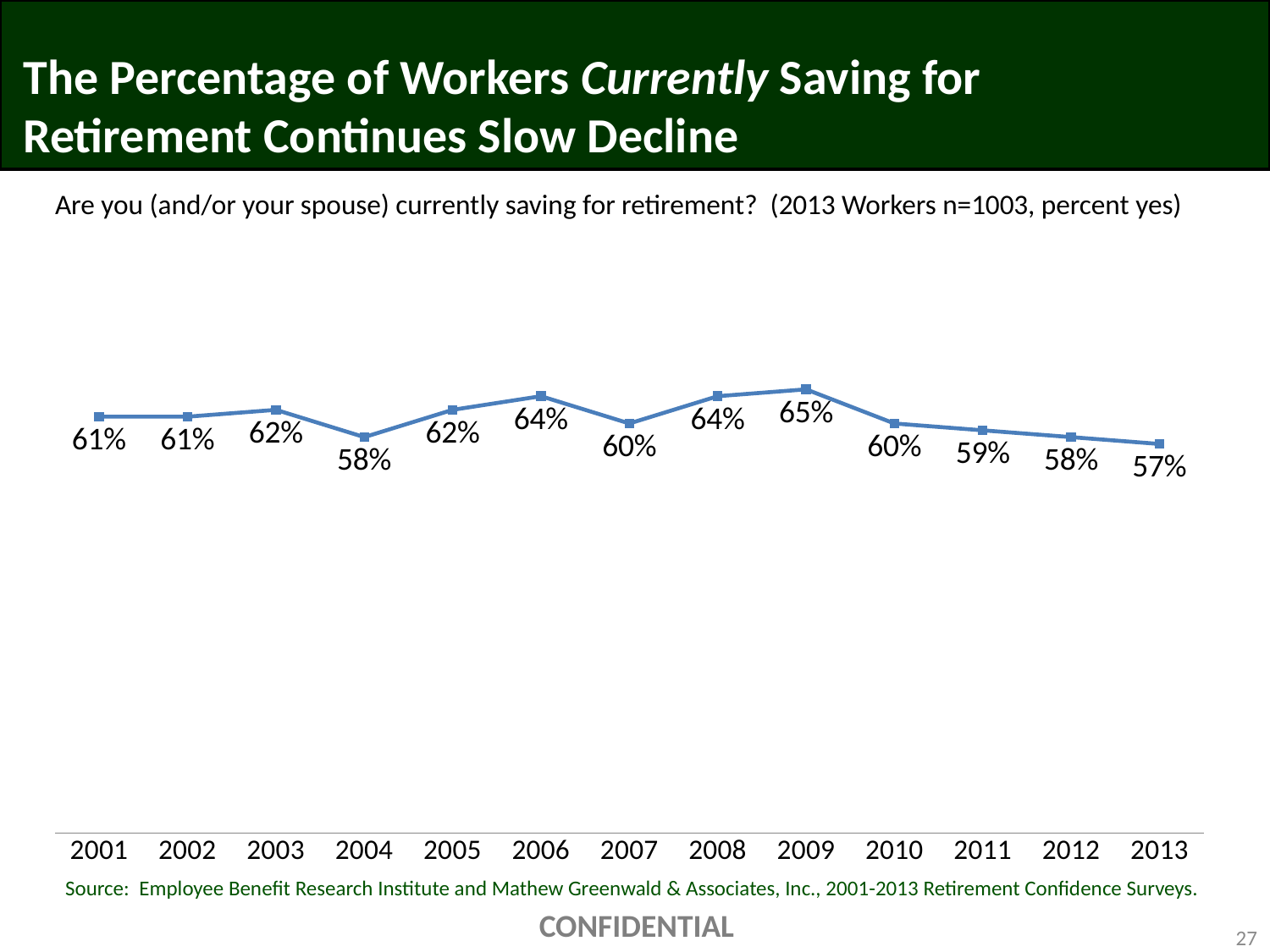
From 2009 to 2013, do the values rise or fall? Fall Which year has a higher value, 2006 or 2007? 2006 What is the sample size of workers given for 2013 in the chart subtitle? n=1003 Which year has the highest percentage of workers currently saving for retirement? 2009 What kind of chart is shown on the slide? Line chart What was the value for 2004? 58% What is the difference between the 2001 value and the 2004 value? 3 percentage points What percentage of workers reported currently saving for retirement in 2013? 57% How many years are plotted on the chart? 13 What was the value for 2009? 65% Which year has the lowest percentage of workers currently saving for retirement? 2013 What is the difference between the 2009 value and the 2013 value? 8 percentage points